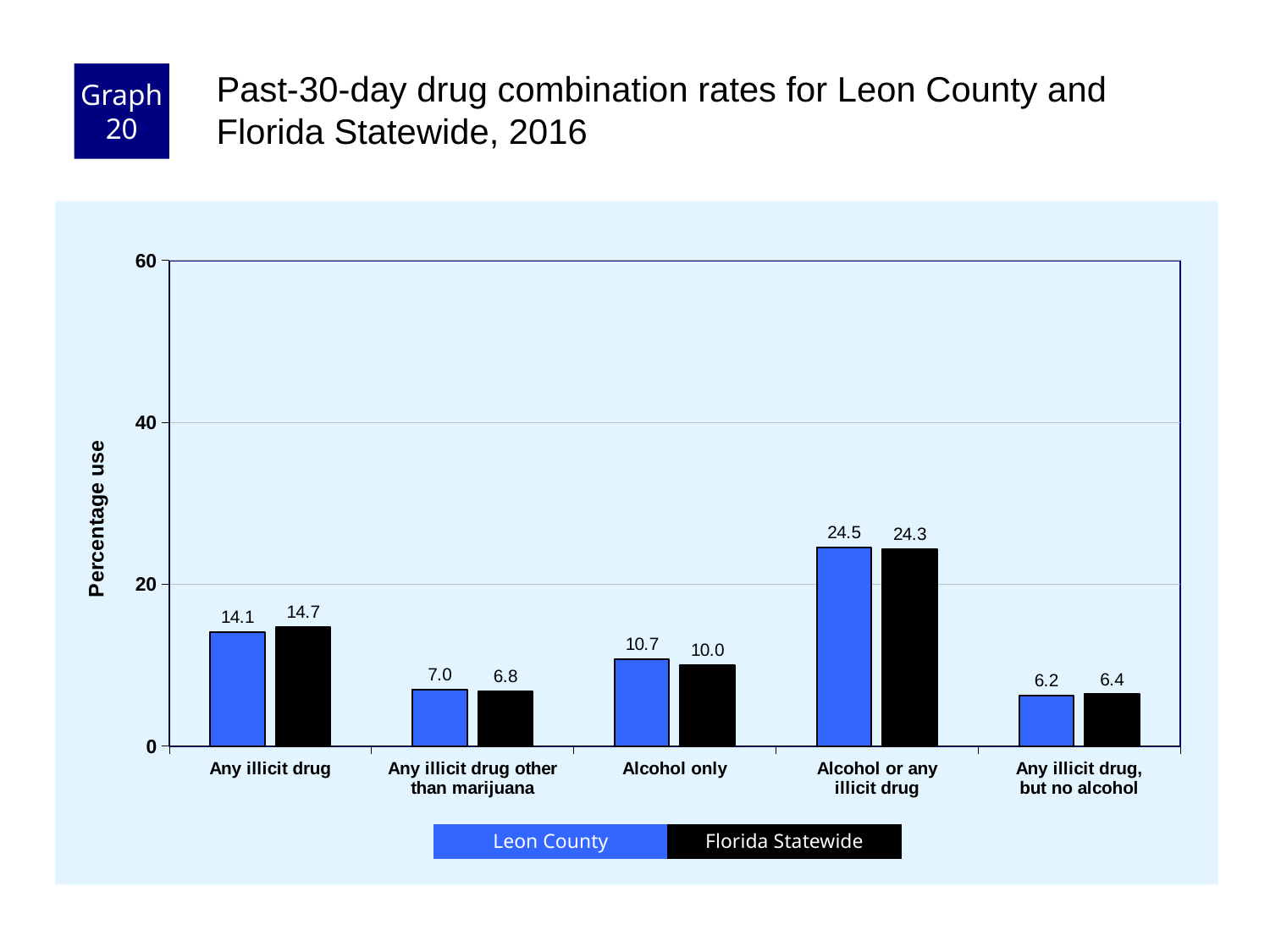
What kind of chart is shown? bar chart Which category has the lowest Florida Statewide value? Any illicit drug, but no alcohol How many series does the legend list? 2 Which is larger for Alcohol only: Leon County or Florida Statewide? Leon County How many categories are shown on the x axis? 5 Which category has the highest Leon County value? Alcohol or any illicit drug Is the Leon County value for Alcohol or any illicit drug greater or less than 20? greater What is the difference between the Florida Statewide and Leon County values for Any illicit drug? 0.6 What is the label of the y axis? Percentage use What is the Leon County value for Any illicit drug? 14.1 What is the Florida Statewide value for Alcohol only? 10.0 What is the Leon County value for Any illicit drug, but no alcohol? 6.2